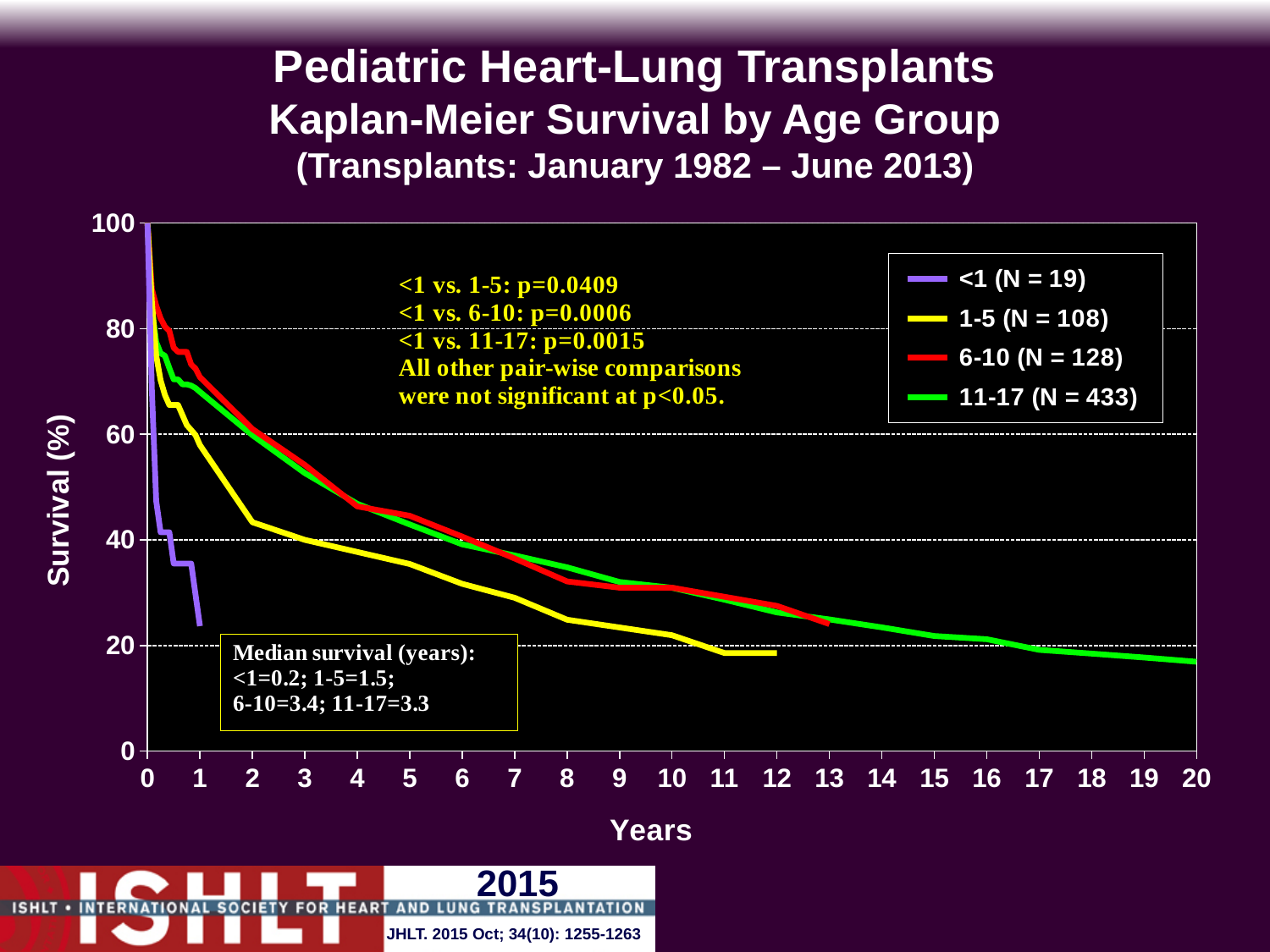
How many age groups (series) does the legend list? 4 At 5 years, which age group has higher survival, 1-5 or 6-10? 6-10 What is the median survival in years for the 6-10 age group? 3.4 What is the N for the 11-17 age group shown in the legend? 433 Which age group has the largest number of patients (N) in the legend? 11-17 What is the p-value for the comparison of <1 vs. 6-10? p=0.0006 What is the N for the <1 age group shown in the legend? 19 Which age group has the shortest median survival? <1 Is the survival for the 1-5 age group at 5 years greater or less than 40%? less What is the median survival in years for the <1 age group? 0.2 Is the survival for the 11-17 age group at 20 years greater or less than 20%? less What kind of chart is shown on the slide? Line chart